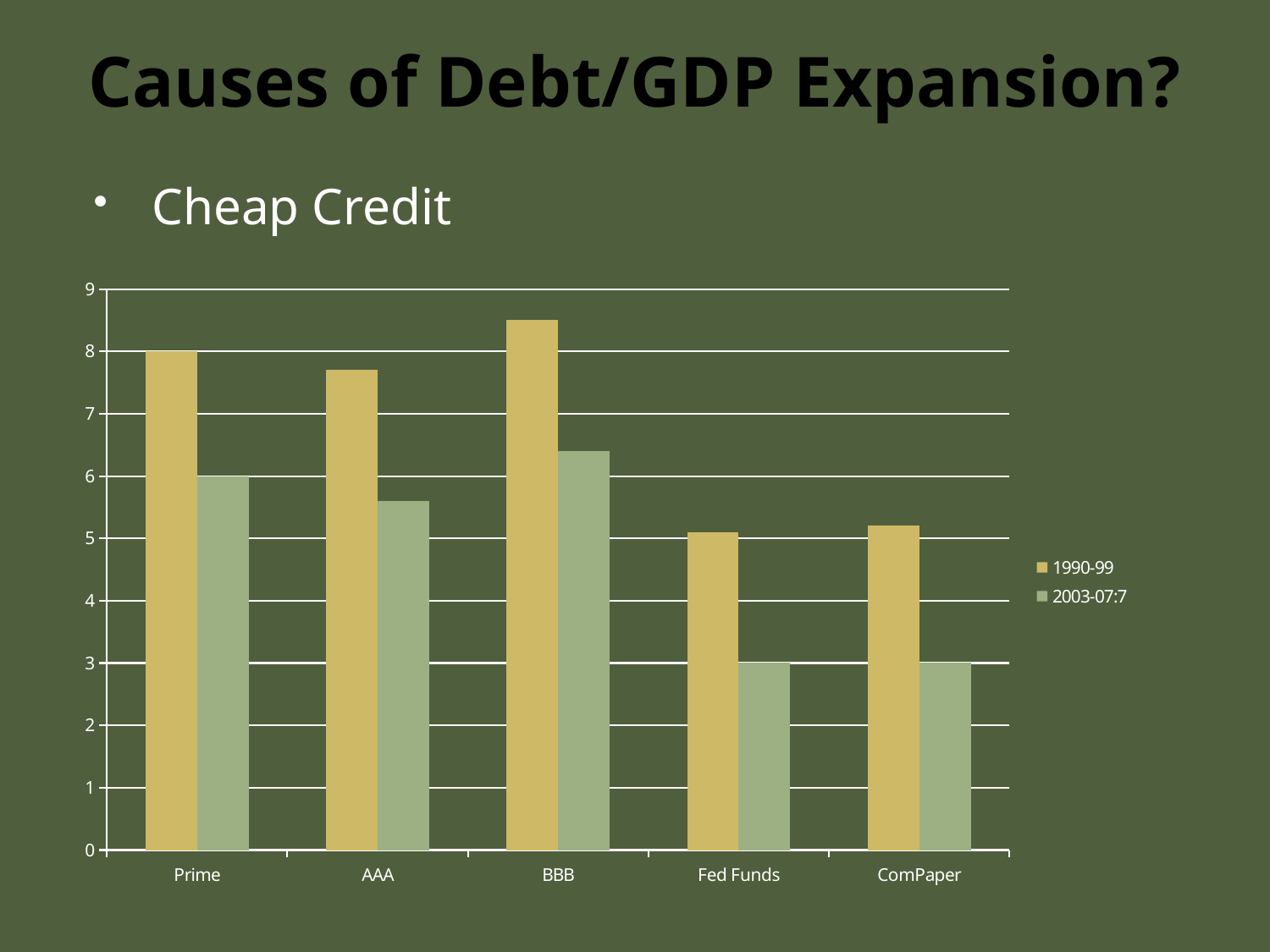
How many categories are shown on the x axis of the chart? 5 How many series does the chart's legend list? 2 What is the value for Prime in the 1990-99 series? 8 Is the value for AAA in the 1990-99 series greater or less than 7? greater What is the value for Prime in the 2003-07:7 series? 6 What is the difference between the 1990-99 and 2003-07:7 values for Prime? 2 Which category has the highest value in the 1990-99 series? BBB Which category has the highest value in the 2003-07:7 series? BBB What type of chart is shown on the slide? bar chart Which series is shown in the lighter green colour in the legend? 2003-07:7 What is the value for Fed Funds in the 2003-07:7 series? 3 Is the value for BBB in the 2003-07:7 series greater or less than 6? greater